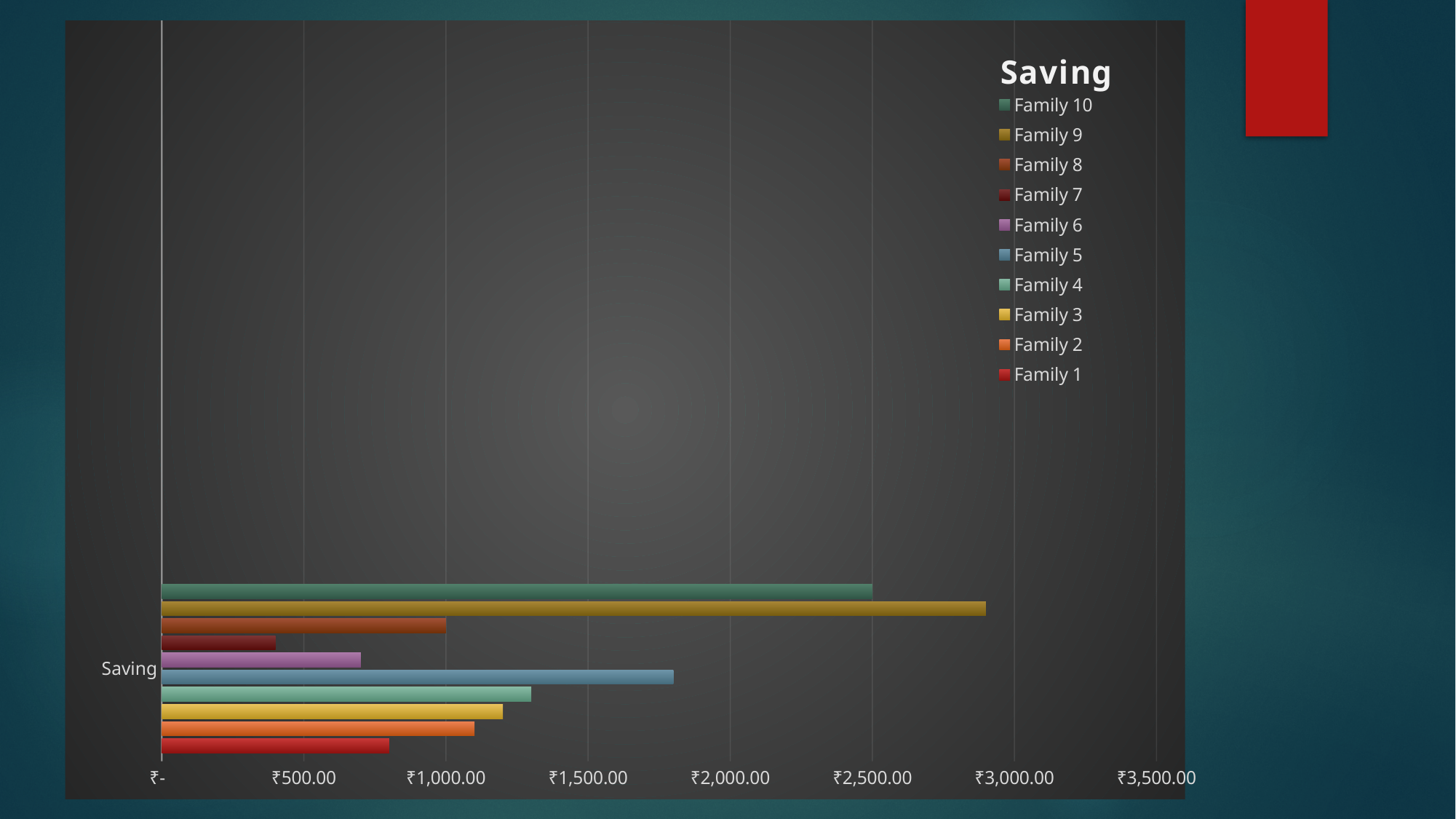
Is the saving for Family 1 greater or less than ₹1,000.00? less How many series does the legend list? 10 Which is larger, the saving for Family 10 or for Family 9? Family 9 Is the saving for Family 7 greater or less than ₹500.00? less How many categories are shown on the vertical axis? 1 What kind of chart is shown on the slide? bar chart What is the title of the chart? Saving Which family has the lowest saving? Family 7 Is the saving for Family 9 greater or less than ₹2,500.00? greater Which family has the highest saving? Family 9 Which is larger, the saving for Family 5 or for Family 4? Family 5